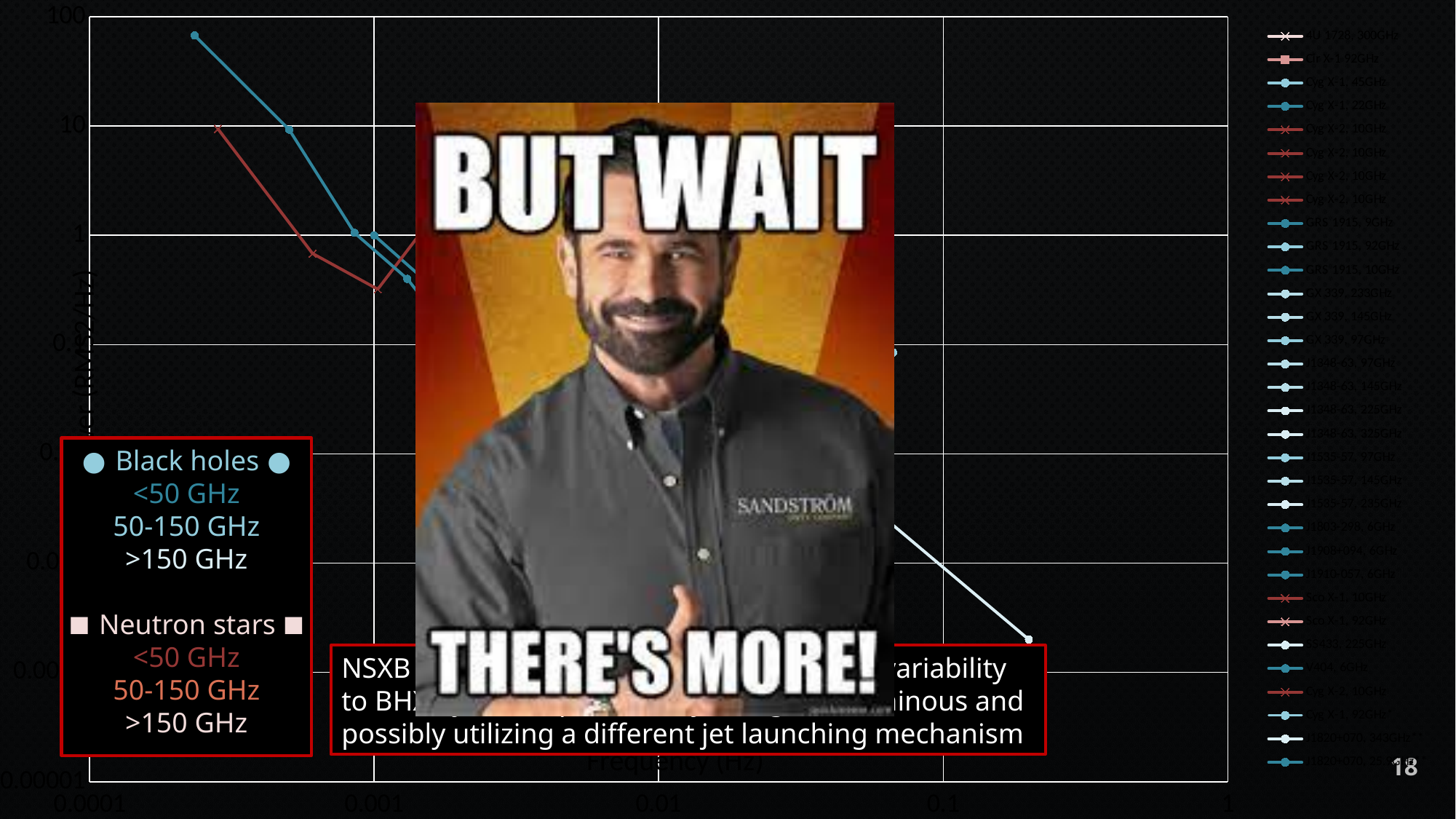
What is the label of the x axis of the chart? Frequency (Hz) Is the value of the light blue point near frequency 0.2 Hz at the right of the chart greater or less than 0.01? less What kind of chart is shown on the slide? line chart Which colour is used for the black hole series in the chart's legend box? blue What is the smallest frequency value labelled on the x axis? 0.0001 Do the plotted lines at the left of the chart rise or fall as frequency increases? fall Is the value of the highest blue point at the left of the chart greater or less than 10? greater At the left edge of the chart, which line is higher, the blue line or the red line? the blue line